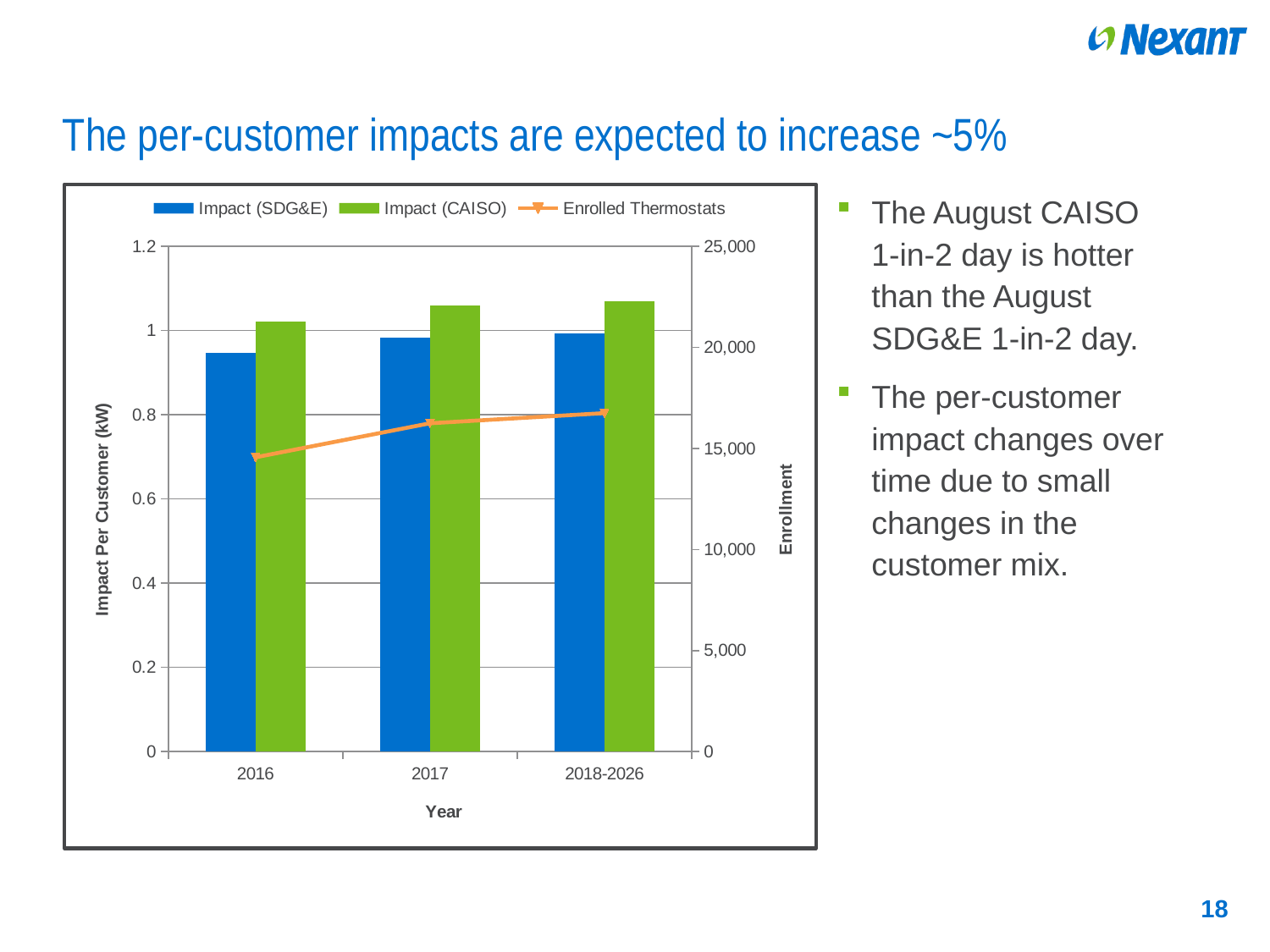
What is the title of the right vertical axis of the chart? Enrollment Is the Impact (CAISO) value for 2017 greater or less than 1 kW? greater How many year categories are shown on the x axis of the chart? 3 Is the Enrolled Thermostats value for 2016 greater or less than 15,000? less Is the Enrolled Thermostats value for 2018-2026 greater or less than 15,000? greater In 2017, which is larger: Impact (SDG&E) or Impact (CAISO)? Impact (CAISO) How many series does the chart legend list? 3 What is the title of the left vertical axis of the chart? Impact Per Customer (kW) Do the Enrolled Thermostats values rise or fall from 2016 to 2018-2026? rise Which year has the lowest Impact (CAISO) value? 2016 What kind of chart is shown on the slide? A bar chart combined with a line